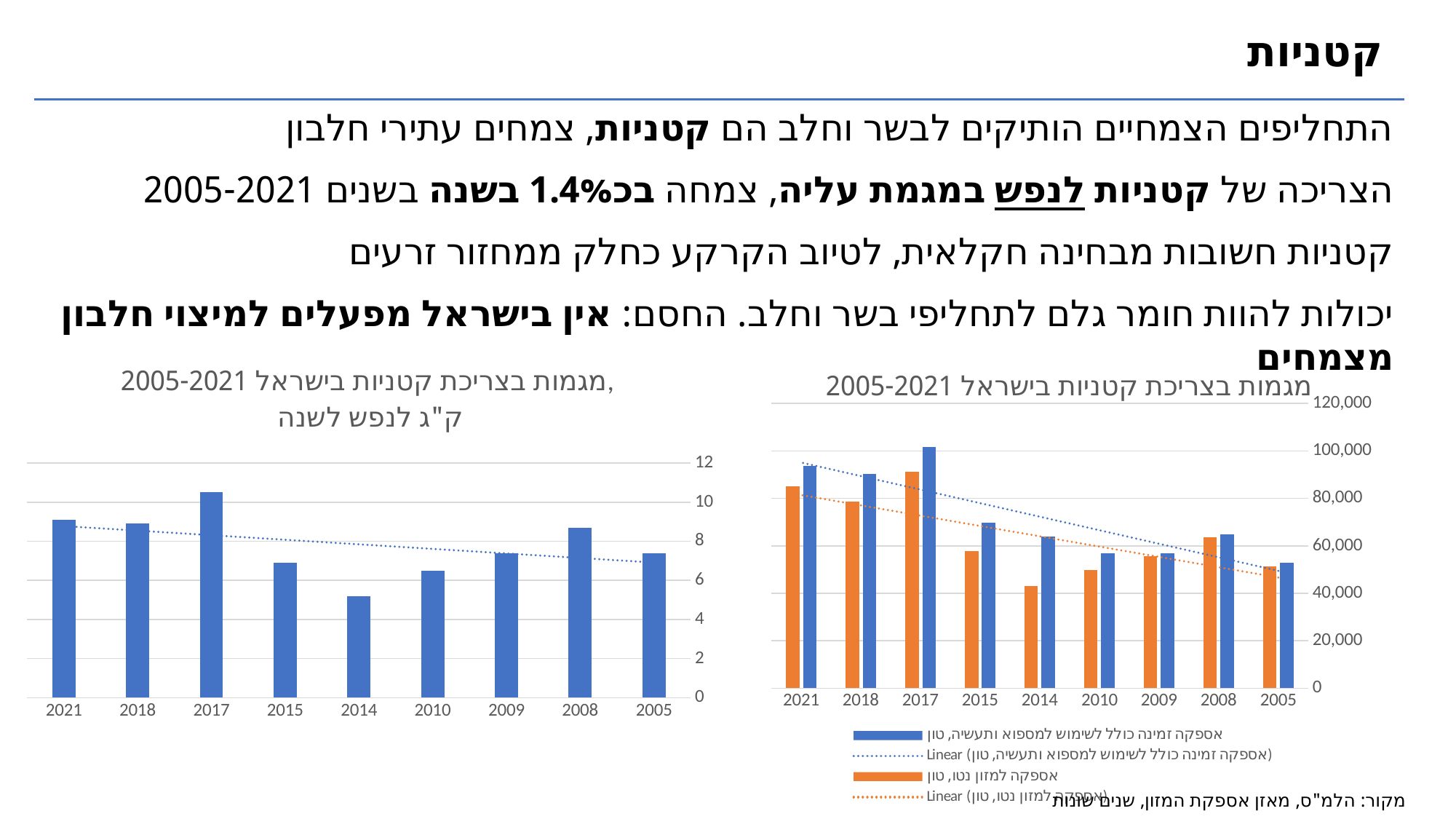
In the left chart, is the value for 2014 greater or less than 6? less In the left chart, which year has the lowest bar? 2014 In the right chart, is the orange bar (אספקה למזון נטו, טון) for 2014 greater or less than 60,000? less In the left chart, how many years are shown on the x axis? 9 In the left chart, is the value for 2021 greater or less than 8? greater In the left chart, which year has the highest bar? 2017 In the right chart, which year has the lowest orange bar (אספקה למזון נטו, טון)? 2014 In the right chart, which year has the highest blue bar (אספקה זמינה כולל לשימוש למספוא ותעשיה, טון)? 2017 What kind of chart is the left chart (ק"ג לנפש לשנה)? bar chart In the right chart, for 2021, which series has the larger bar, the blue one or the orange one? blue In the left chart, which is larger, the value for 2018 or the value for 2015? 2018 In the right chart, how many entries does the legend list? 4